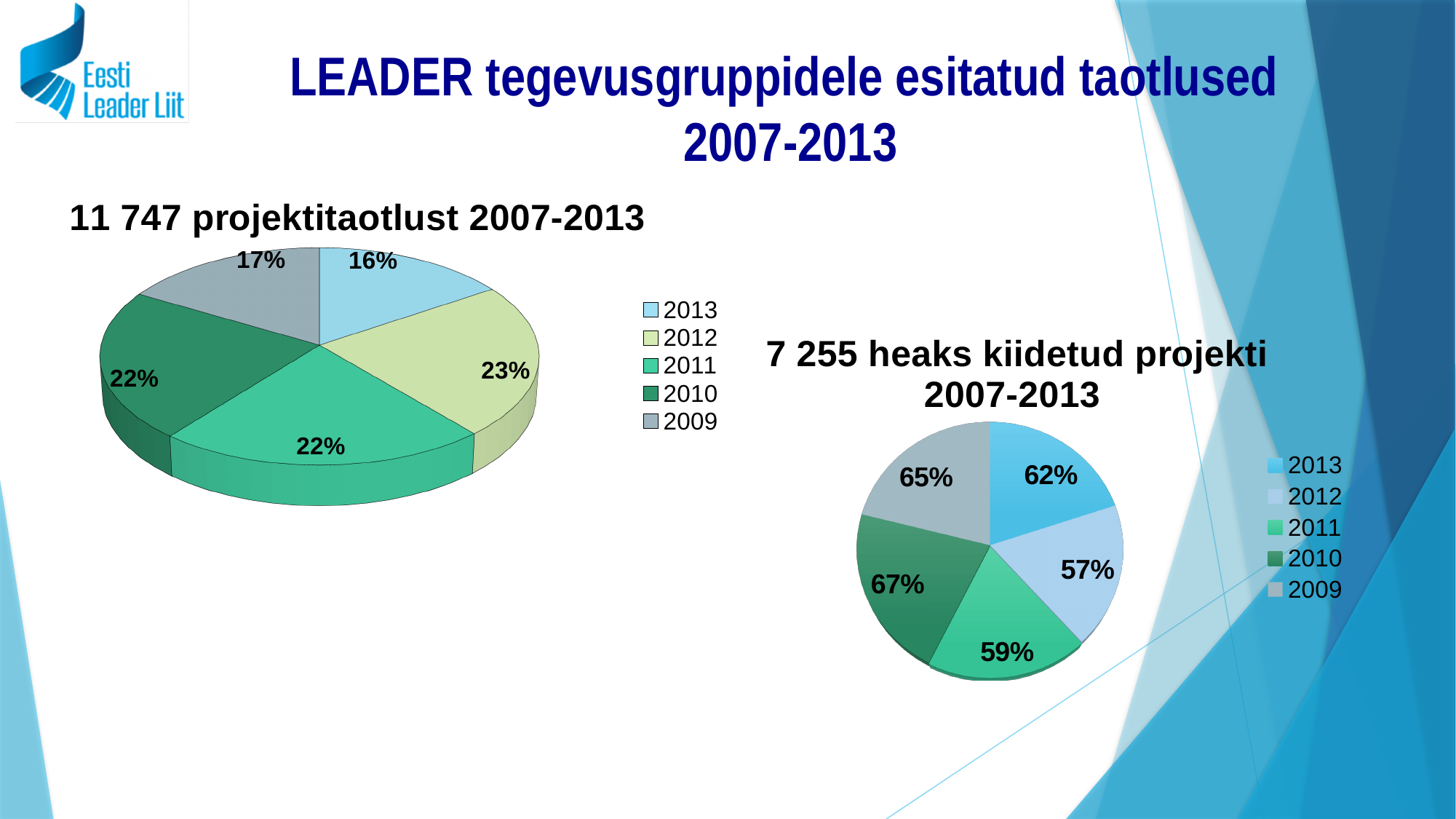
What type of chart is used for "11 747 projektitaotlust 2007-2013"? pie chart How many entries does the legend of the "7 255 heaks kiidetud projekti 2007-2013" chart list? 5 In the "7 255 heaks kiidetud projekti 2007-2013" chart, what percentage is shown for 2012? 57% In the "7 255 heaks kiidetud projekti 2007-2013" chart, which is larger, the value for 2013 or the value for 2011? 2013 In the "7 255 heaks kiidetud projekti 2007-2013" chart, what is the difference between the 2010 and 2012 percentages? 10% In the "11 747 projektitaotlust 2007-2013" chart, what percentage is shown for 2012? 23% In the "11 747 projektitaotlust 2007-2013" chart, what percentage is shown for 2013? 16% How many slices does the "11 747 projektitaotlust 2007-2013" pie chart have? 5 In the "11 747 projektitaotlust 2007-2013" chart, which year has the largest slice? 2012 In the "11 747 projektitaotlust 2007-2013" chart, what is the difference between the 2012 and 2009 percentages? 6% In the "11 747 projektitaotlust 2007-2013" chart, which year has the smallest slice? 2013 In the "7 255 heaks kiidetud projekti 2007-2013" chart, what percentage is shown for 2010? 67%